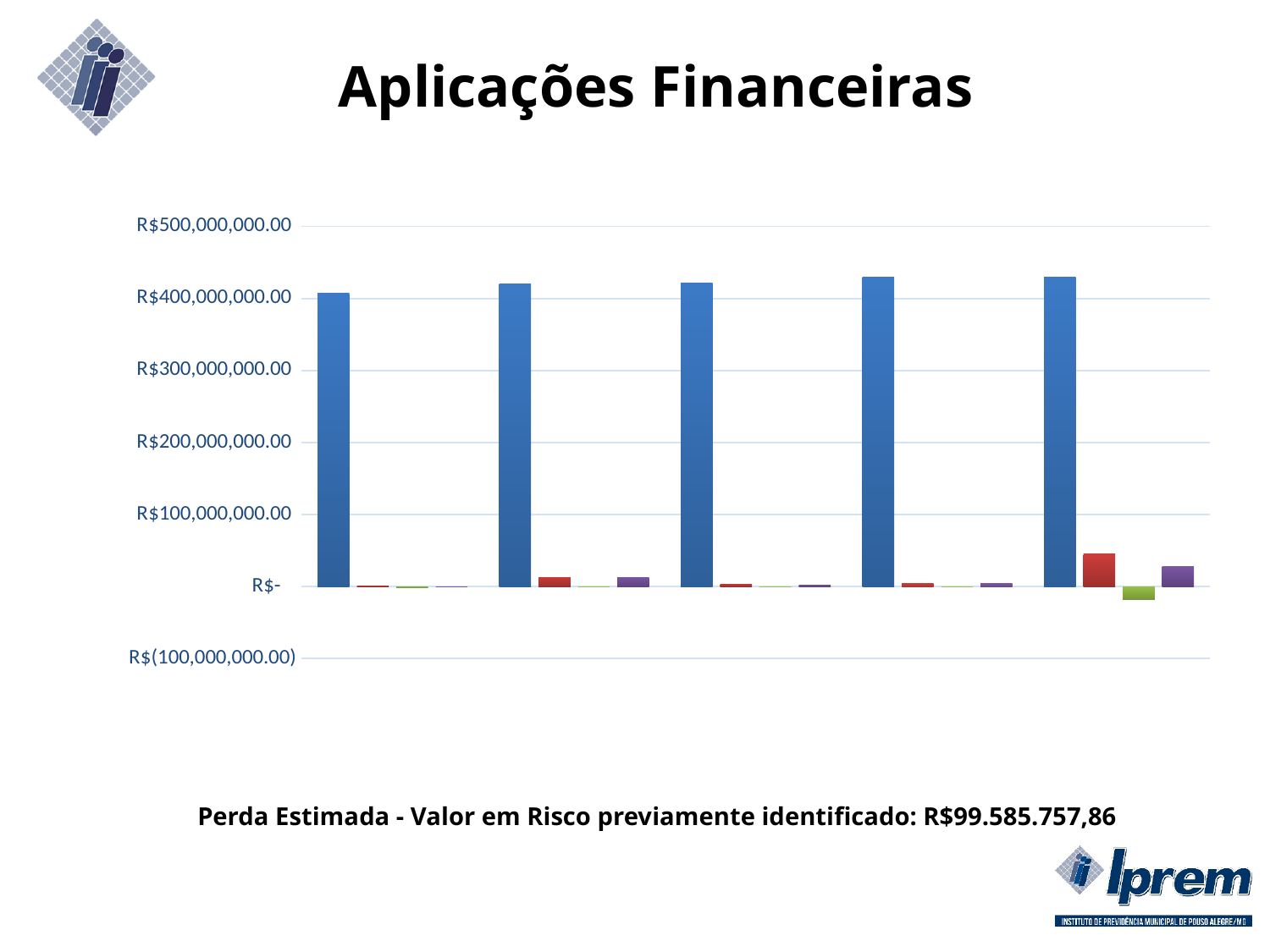
How many differently coloured series appear in the chart? 4 What kind of chart is shown on the slide? bar chart Which group has the lowest blue bar? the first group Is the value of the red bar in the fifth group greater or less than R$100,000,000.00? less Is the value of the blue bar in the first group greater or less than R$300,000,000.00? greater Is the value of the blue bar in the fifth group greater or less than R$500,000,000.00? less What is the lowest value shown on the vertical axis? R$(100,000,000.00) How many groups of bars are plotted along the x axis? 5 Do the blue bars generally rise or fall from left to right? rise Is the blue bar in the second group larger or smaller than the blue bar in the first group? larger What is the title of the slide containing the chart? Aplicações Financeiras